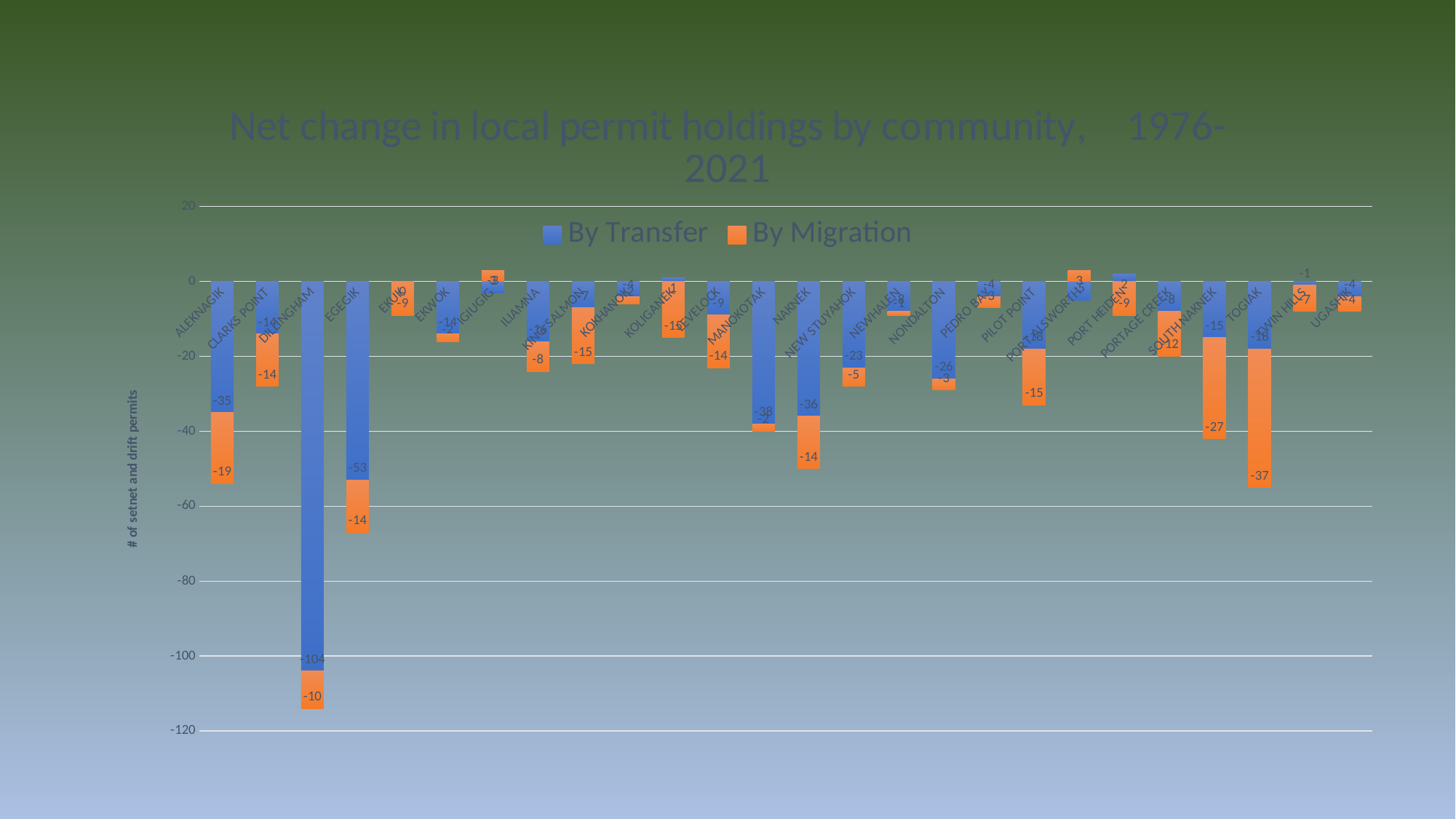
What type of chart is shown on the slide? Bar chart What is the By Migration value for Togiak? -37 Which community has the lowest (most negative) By Migration value? Togiak How many communities are shown on the x axis? 26 Which community has the lowest (most negative) By Transfer value? Dillingham What is the total of the stacked bar for Dillingham? -114 How many series does the legend list? 2 What is the By Transfer value for Aleknagik? -35 Which has the larger By Transfer loss, Egegik or Naknek? Egegik What is the y-axis title of the chart? # of setnet and drift permits What is the By Transfer value for Dillingham? -104 What is the difference between the By Transfer and By Migration values for Aleknagik? 16